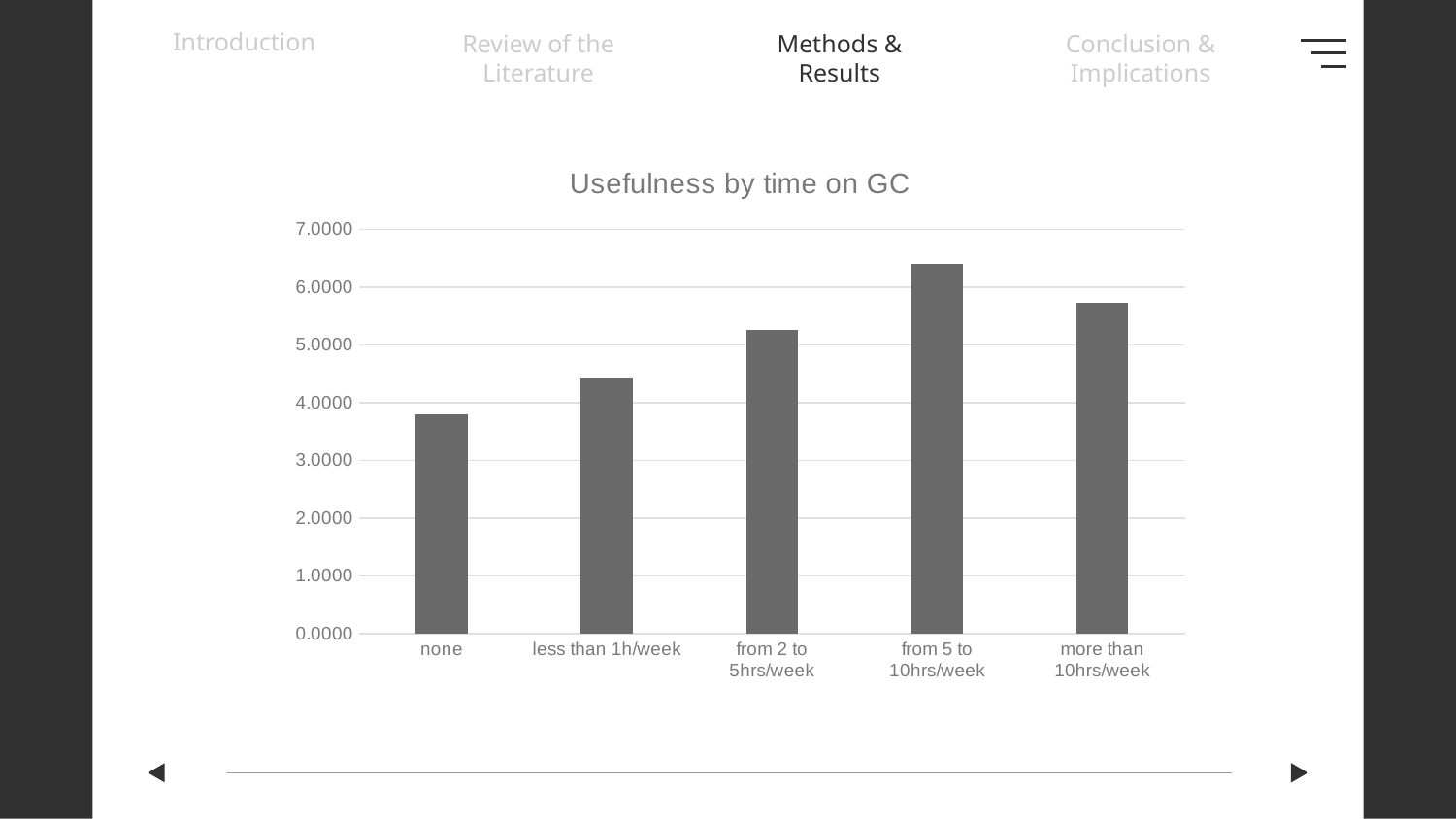
Which category has the lowest value in the chart? none How many categories are shown on the x axis of the chart? 5 Which is larger, the value for 'from 2 to 5hrs/week' or the value for 'more than 10hrs/week'? more than 10hrs/week Is the value for 'more than 10hrs/week' greater or less than 6.0000? less Is the value for 'less than 1h/week' greater or less than 4.0000? greater Is the value for 'none' greater or less than 4.0000? less What kind of chart is shown on the slide? bar chart Which is larger, the value for 'none' or the value for 'less than 1h/week'? less than 1h/week Which category has the highest value in the chart? from 5 to 10hrs/week What is the title of the chart? Usefulness by time on GC Do the values rise or fall from 'none' to 'from 5 to 10hrs/week' along the x axis? rise